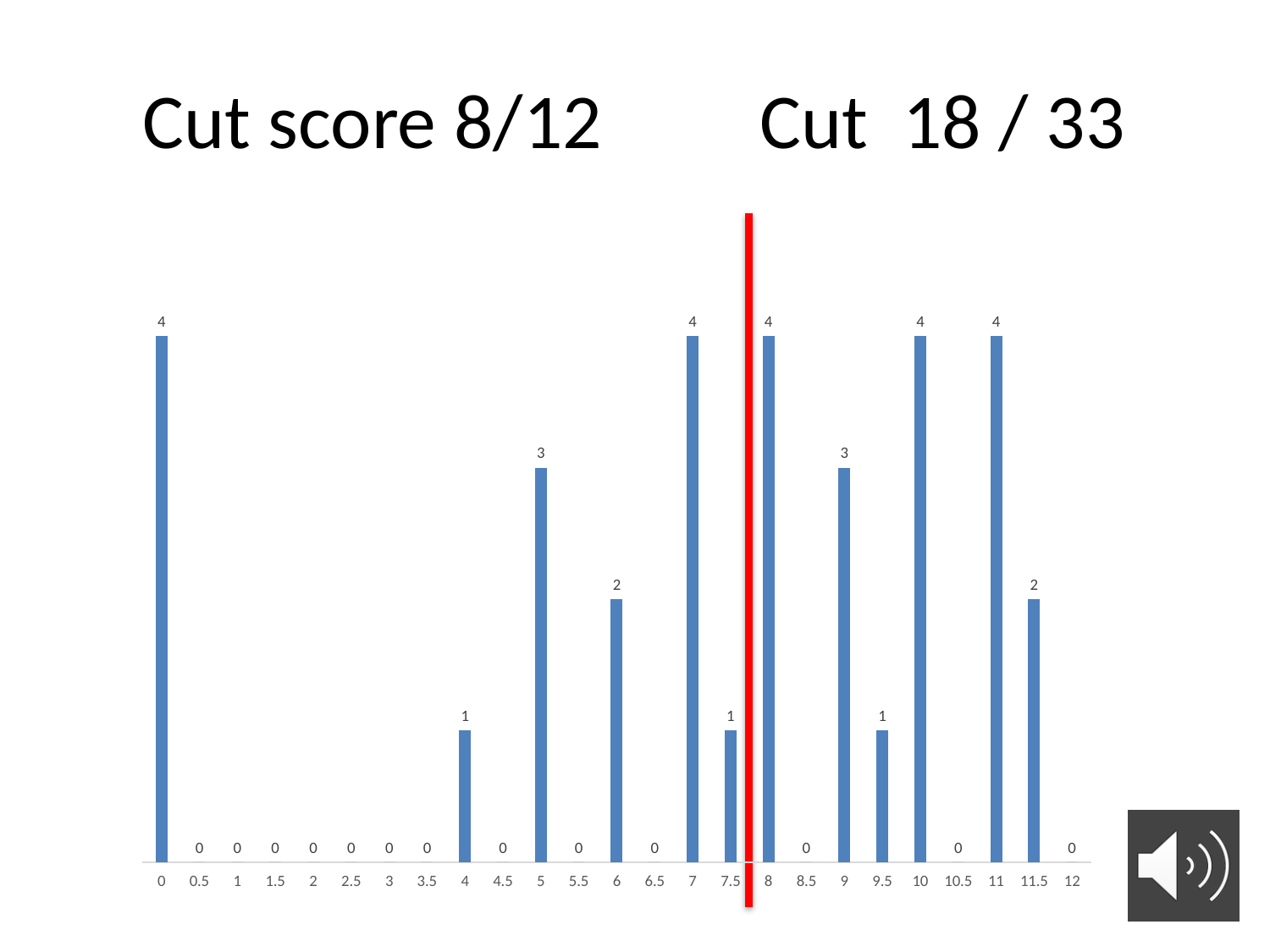
What kind of chart is shown on the slide? bar chart What is the text of the title above the chart? Cut score 8/12 Cut 18 / 33 What is the difference between the values for category 7 and category 6? 2 Which has the larger value, category 5 or category 6? 5 Which has the larger value, category 9 or category 9.5? 9 What is the value for category 5? 3 How many categories are shown on the x axis? 25 What is the highest value shown by any bar in the chart? 4 What is the value for category 0? 4 What is the value for category 11.5? 2 What is the value for category 9.5? 1 What is the value for category 12? 0